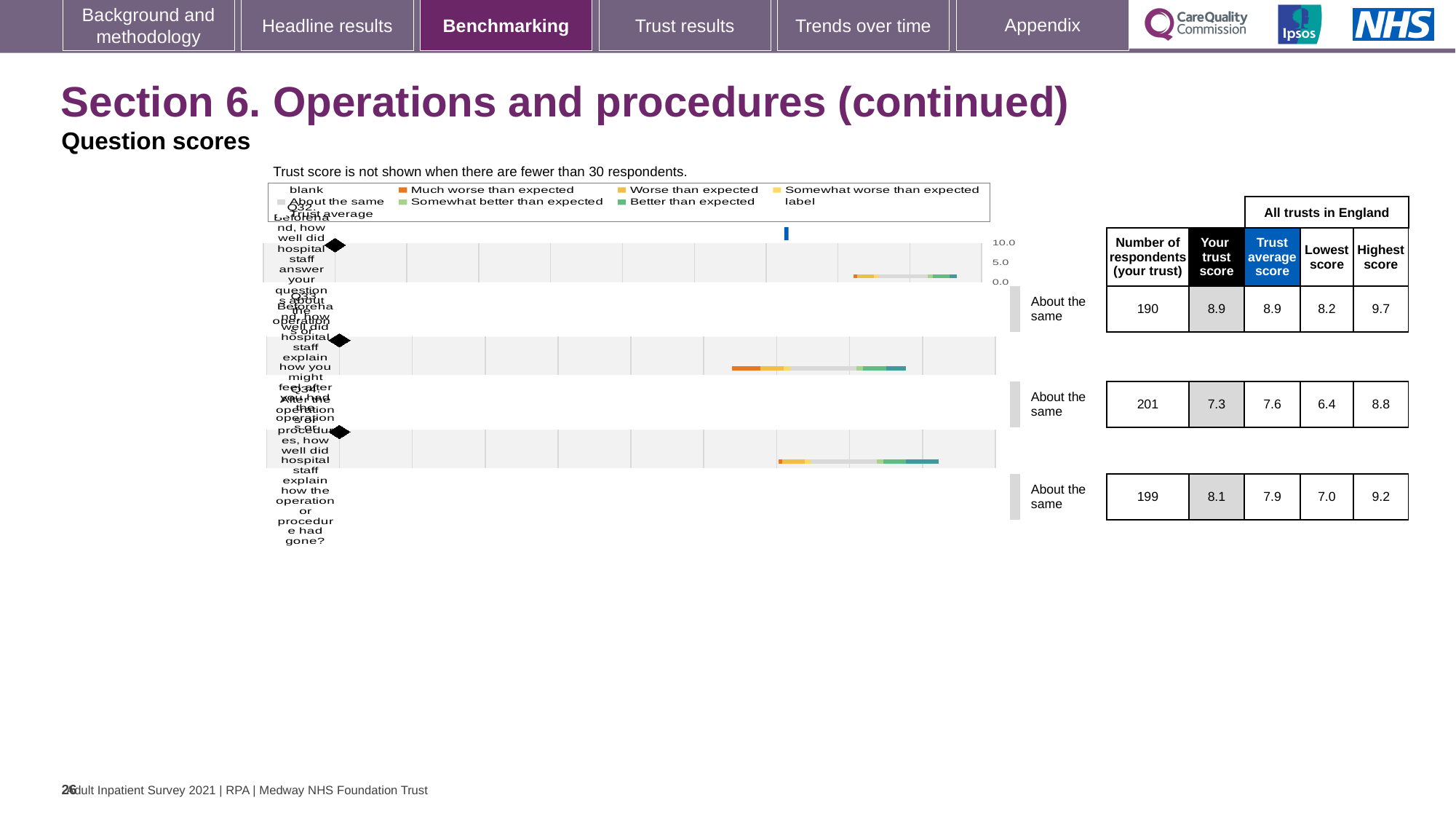
In the table beside the charts, what is the highest score for the third (bottom) question row? 9.2 What benchmark category label is shown next to each of the three question rows? About the same In the table beside the charts, what is the number of respondents for the first (top) question row? 190 What kind of chart is used to show the question scores on this slide? bar chart For the third (bottom) question row, what is the difference between the highest score and the lowest score? 2.2 In the table beside the charts, what is the trust average score for the second question row? 7.6 Which question row has the highest 'Your trust score' in the table? the first (top) row, 8.9 How many question rows (charts) are shown on the slide? 3 Which question row has the lowest 'Your trust score' in the table? the second row, 7.3 According to the note above the charts, when is the trust score not shown? when there are fewer than 30 respondents In the table beside the charts, what is 'Your trust score' for the first (top) question row? 8.9 For the second question row, which is larger: 'Your trust score' or the trust average score? trust average score